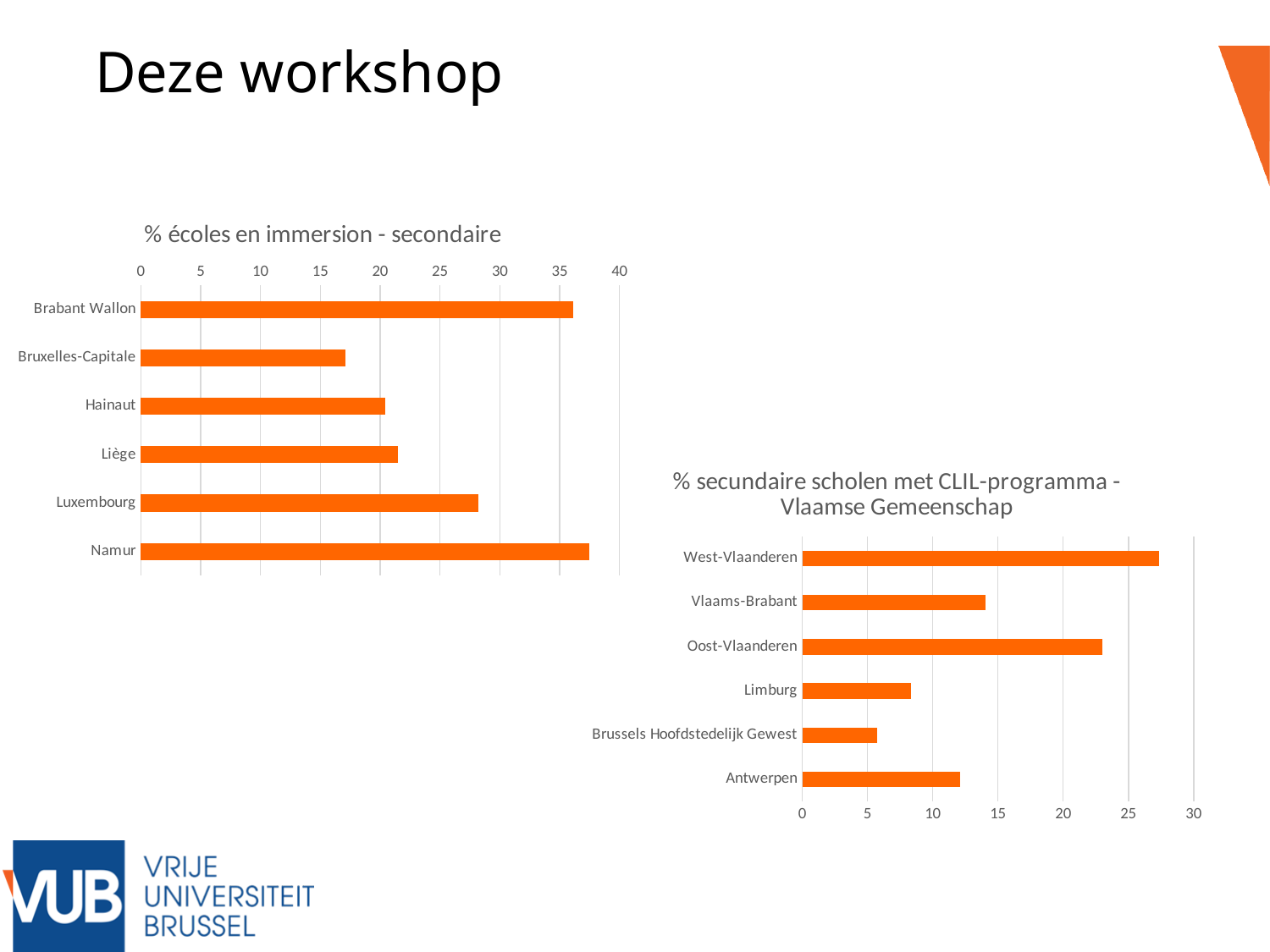
In the chart titled '% écoles en immersion - secondaire', is the value for Brabant Wallon greater or less than 30? greater In the chart titled '% écoles en immersion - secondaire', is the value for Luxembourg greater or less than 25? greater In the chart titled '% secundaire scholen met CLIL-programma - Vlaamse Gemeenschap', is the value for Limburg greater or less than 10? less In the chart titled '% secundaire scholen met CLIL-programma - Vlaamse Gemeenschap', which category has the lowest value? Brussels Hoofdstedelijk Gewest What kind of chart is the chart titled '% secundaire scholen met CLIL-programma - Vlaamse Gemeenschap'? Bar chart In the chart titled '% écoles en immersion - secondaire', which is larger, the value for Luxembourg or the value for Hainaut? Luxembourg In the chart titled '% secundaire scholen met CLIL-programma - Vlaamse Gemeenschap', which is larger, the value for Vlaams-Brabant or the value for Antwerpen? Vlaams-Brabant In the chart titled '% écoles en immersion - secondaire', which category has the lowest value? Bruxelles-Capitale In the chart titled '% secundaire scholen met CLIL-programma - Vlaamse Gemeenschap', which category has the highest value? West-Vlaanderen How many categories are shown in the chart titled '% écoles en immersion - secondaire'? 6